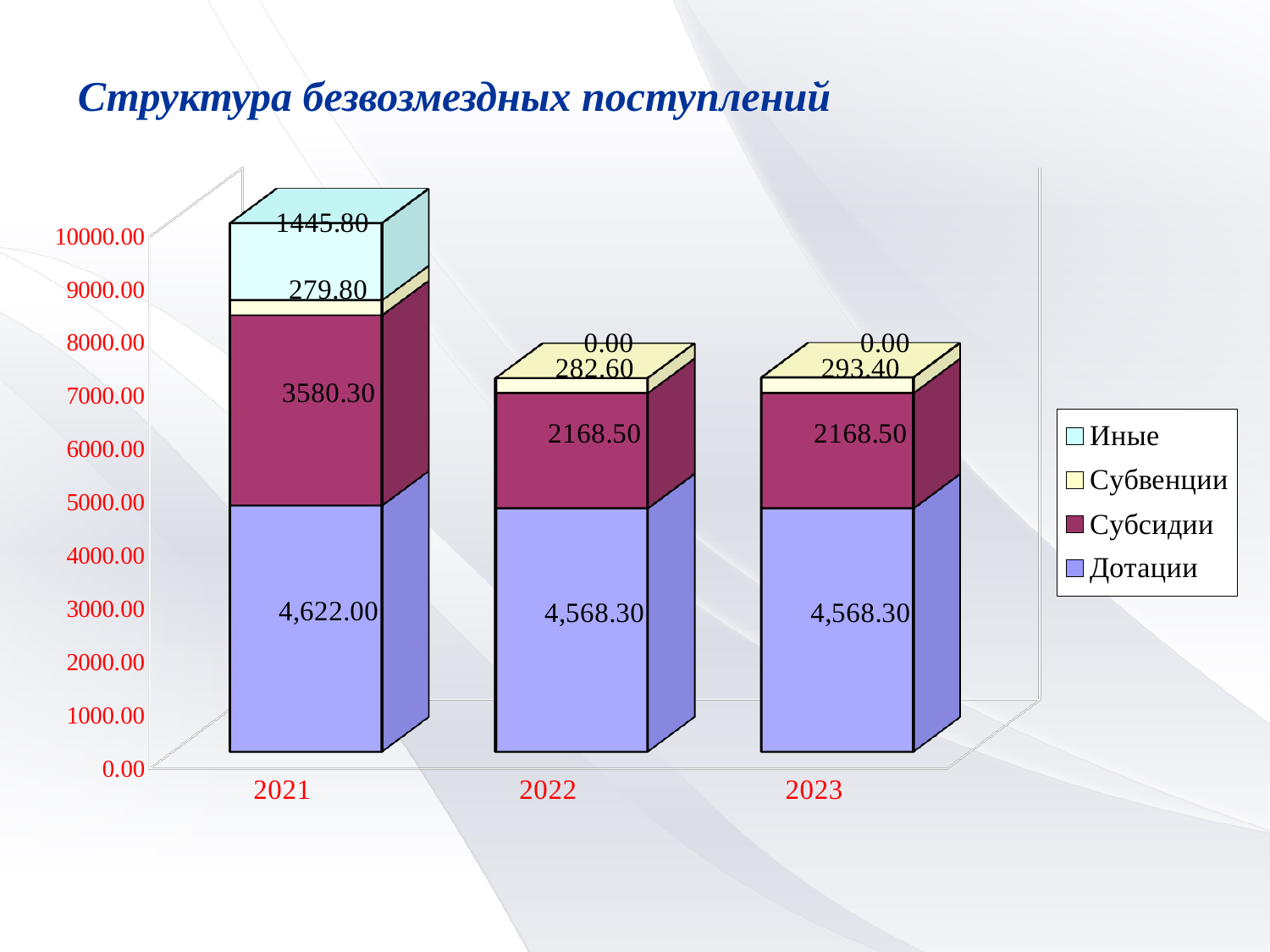
In which year is the value of Субсидии highest? 2021 In which year is the value of Субвенции lowest? 2021 What is the value of Субвенции for 2023? 293.40 What is the total of the stacked bar for 2022? 7019.40 Which is larger: Дотации in 2021 or Дотации in 2022? Дотации in 2021 What is the value of Иные for 2021? 1445.80 How many series does the legend list? 4 What kind of chart is shown on the slide? Stacked bar chart What is the value of Дотации for 2021? 4,622.00 What is the value of Субсидии for 2022? 2168.50 How many years are shown on the x axis? 3 What is the difference between the Субсидии values for 2021 and 2022? 1411.80